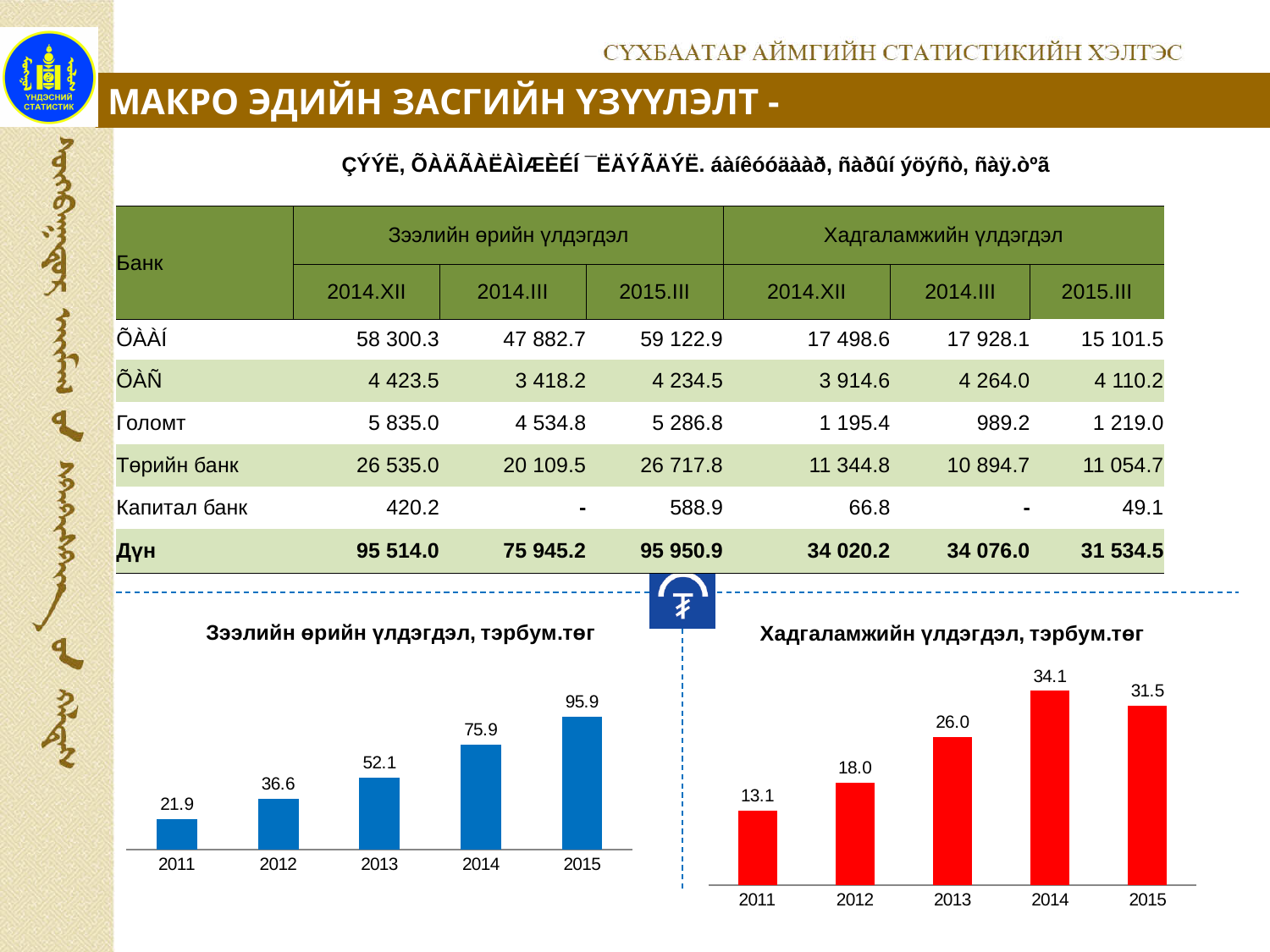
What kind of chart is the chart titled "Хадгаламжийн үлдэгдэл, тэрбум.төг"? bar chart In the chart titled "Хадгаламжийн үлдэгдэл, тэрбум.төг", which year has the highest value? 2014 In the chart titled "Зээлийн өрийн үлдэгдэл, тэрбум.төг", do the values rise or fall from 2011 to 2015? rise In the chart titled "Зээлийн өрийн үлдэгдэл, тэрбум.төг", what is the value for 2013? 52.1 In the chart titled "Хадгаламжийн үлдэгдэл, тэрбум.төг", what is the value for 2012? 18.0 How many years are shown in the chart titled "Зээлийн өрийн үлдэгдэл, тэрбум.төг"? 5 What colour are the bars in the chart titled "Хадгаламжийн үлдэгдэл, тэрбум.төг"? red In the chart titled "Зээлийн өрийн үлдэгдэл, тэрбум.төг", which year has the highest value? 2015 In the chart titled "Зээлийн өрийн үлдэгдэл, тэрбум.төг", what is the difference between the values for 2015 and 2014? 20.0 In the chart titled "Хадгаламжийн үлдэгдэл, тэрбум.төг", which year has the lowest value? 2011 In the chart titled "Хадгаламжийн үлдэгдэл, тэрбум.төг", which is larger, the value for 2013 or the value for 2015? 2015 In the chart titled "Хадгаламжийн үлдэгдэл, тэрбум.төг", what is the difference between the values for 2014 and 2015? 2.6